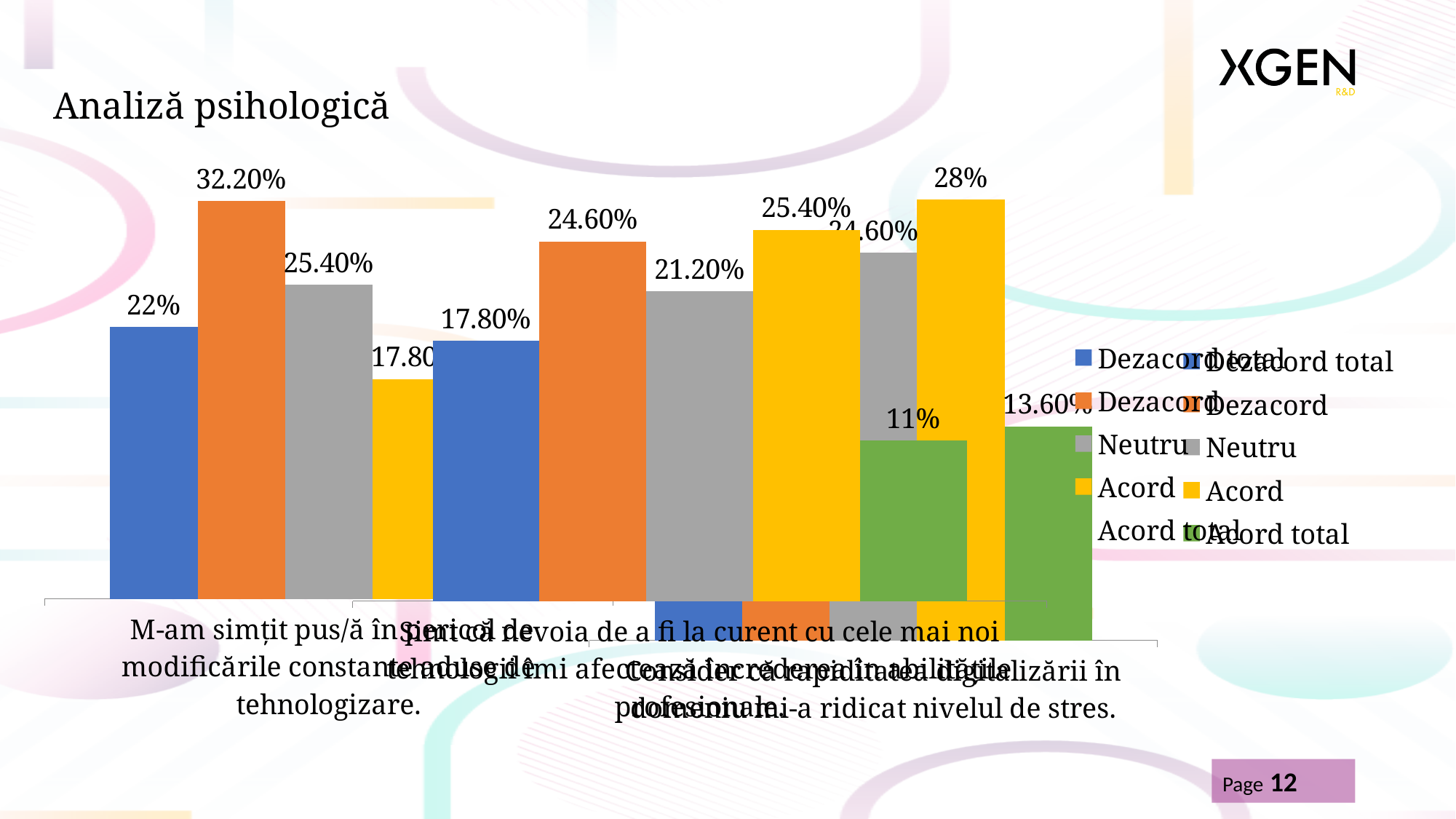
What is the value of the Dezacord total (blue) bar for the leftmost category? 22% What value is labelled on the tallest Acord (yellow) bar? 28% Which colour represents the Acord total series in the legend? green For the leftmost category, what is the difference between the Dezacord value and the Dezacord total value? 10.20% How many series does the chart legend list? 5 What is the highest value labelled on the chart? 32.20% What are the series names listed in the legend? Dezacord total, Dezacord, Neutru, Acord, Acord total What kind of chart is shown on the slide? bar chart For the leftmost category, which is larger: Dezacord or Dezacord total? Dezacord What is the value of the Dezacord (orange) bar for the leftmost category? 32.20% What is the value of the Neutru (grey) bar for the leftmost category? 25.40%